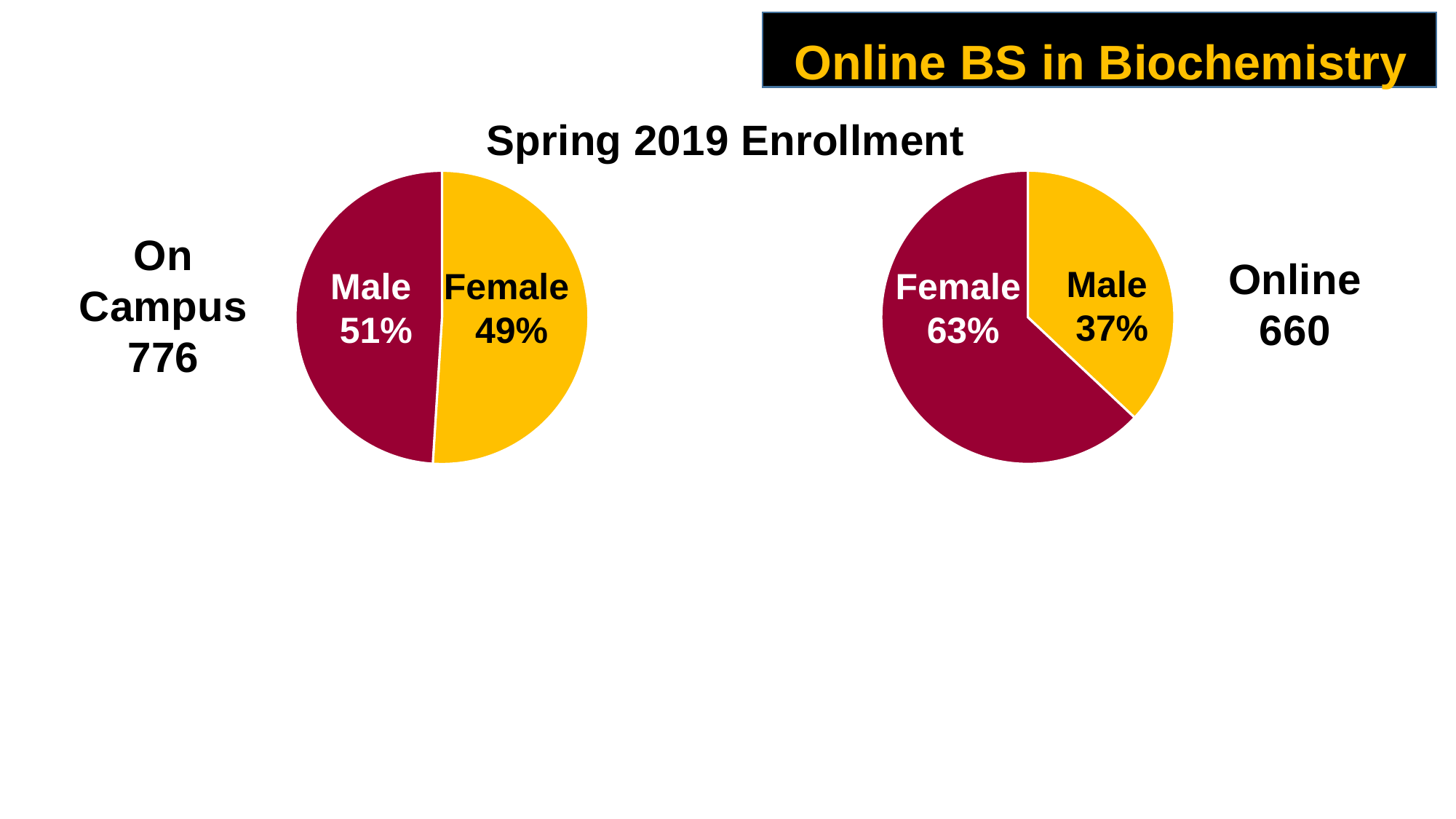
How many slices does the Online pie chart have? 2 What kind of chart is used to show the On Campus enrollment? Pie chart In the On Campus pie chart, what share of enrollment is Male? 51% In the On Campus pie chart, what share of enrollment is Female? 49% In the Online pie chart, what share of enrollment is Male? 37% What is the title shown above the two pie charts? Spring 2019 Enrollment In the Online pie chart, what share of enrollment is Female? 63% What is the total Online enrollment shown next to the right pie chart? 660 In the On Campus pie chart, what is the difference between the Male and Female shares? 2% In the Online pie chart, what is the difference between the Female and Male shares? 26% In the Online pie chart, which slice is larger, Male or Female? Female What is the total On Campus enrollment shown next to the left pie chart? 776